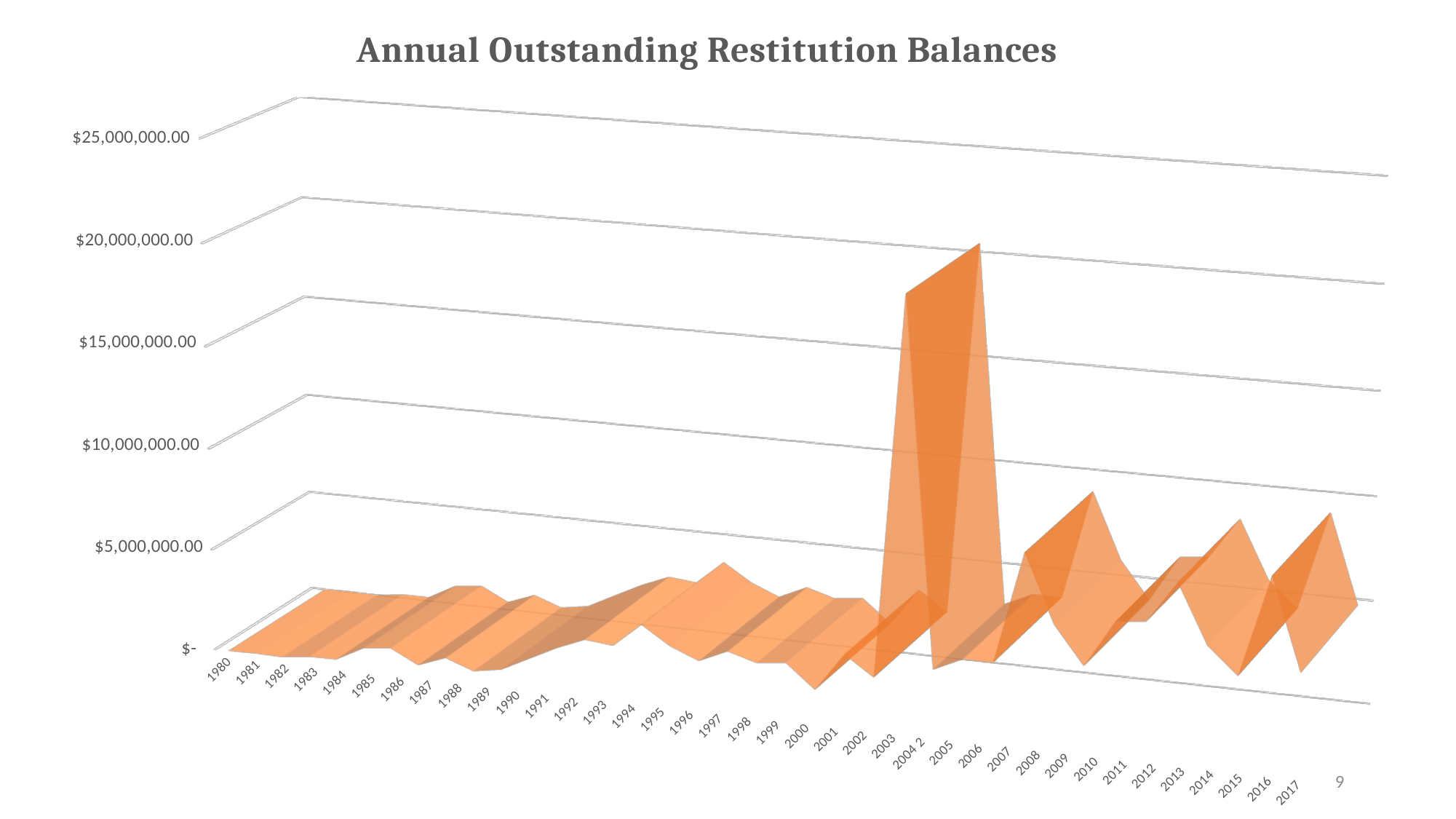
Is the value for 2010 greater or less than $10,000,000.00? less Which year has the highest outstanding restitution balance? 2004 What is the highest value labelled on the vertical axis? $25,000,000.00 Is the value for 1980 greater or less than $5,000,000.00? less What kind of chart is shown on the slide? line chart What is the last year shown on the x axis? 2017 Which is larger, the value for 2004 or the value for 2010? 2004 How many years are shown along the x axis? 38 What is the title of the chart? Annual Outstanding Restitution Balances Is the value for 2004 greater or less than $10,000,000.00? greater Which is larger, the value for 1980 or the value for 2004? 2004 What is the first year shown on the x axis? 1980